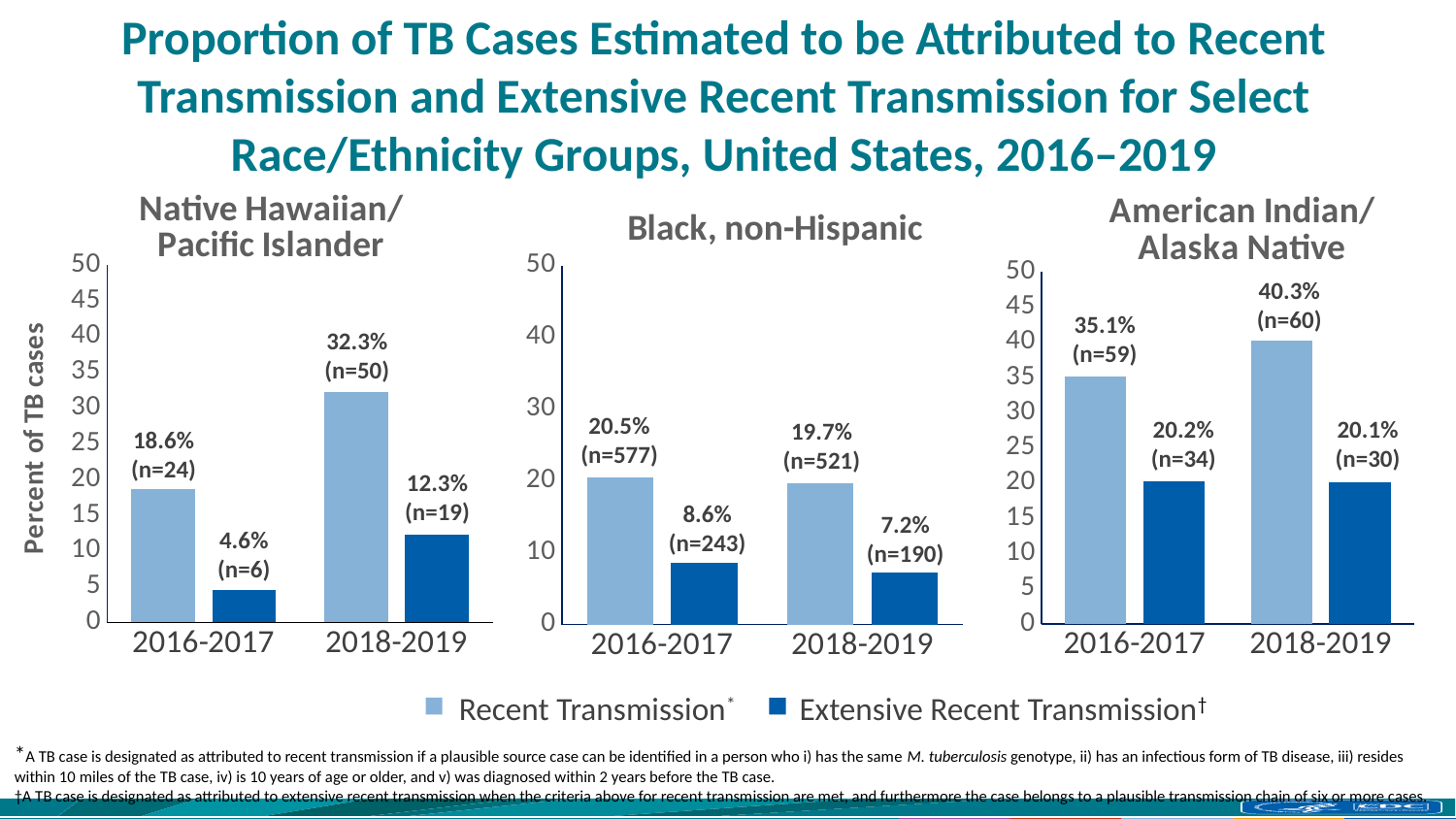
How many series does the legend list? 2 In the American Indian/Alaska Native chart, which bar is the highest? Recent Transmission, 2018-2019 In the Black, non-Hispanic chart, is the Recent Transmission value for 2018-2019 greater or less than 20? less What kind of chart is the Black, non-Hispanic chart? Bar chart In the Native Hawaiian/Pacific Islander chart, what is the Recent Transmission value for 2018-2019? 32.3% In the Native Hawaiian/Pacific Islander chart, what is the difference between the Recent Transmission values for 2018-2019 and 2016-2017? 13.7% In the Black, non-Hispanic chart, what is the Extensive Recent Transmission value for 2016-2017? 8.6% In the Black, non-Hispanic chart, which period has the higher Recent Transmission value, 2016-2017 or 2018-2019? 2016-2017 In the American Indian/Alaska Native chart, what is the Recent Transmission value for 2016-2017? 35.1% How many charts are shown on the slide? 3 In the Native Hawaiian/Pacific Islander chart, which bar is the lowest? Extensive Recent Transmission, 2016-2017 In the American Indian/Alaska Native chart, does the Recent Transmission value rise or fall from 2016-2017 to 2018-2019? Rise